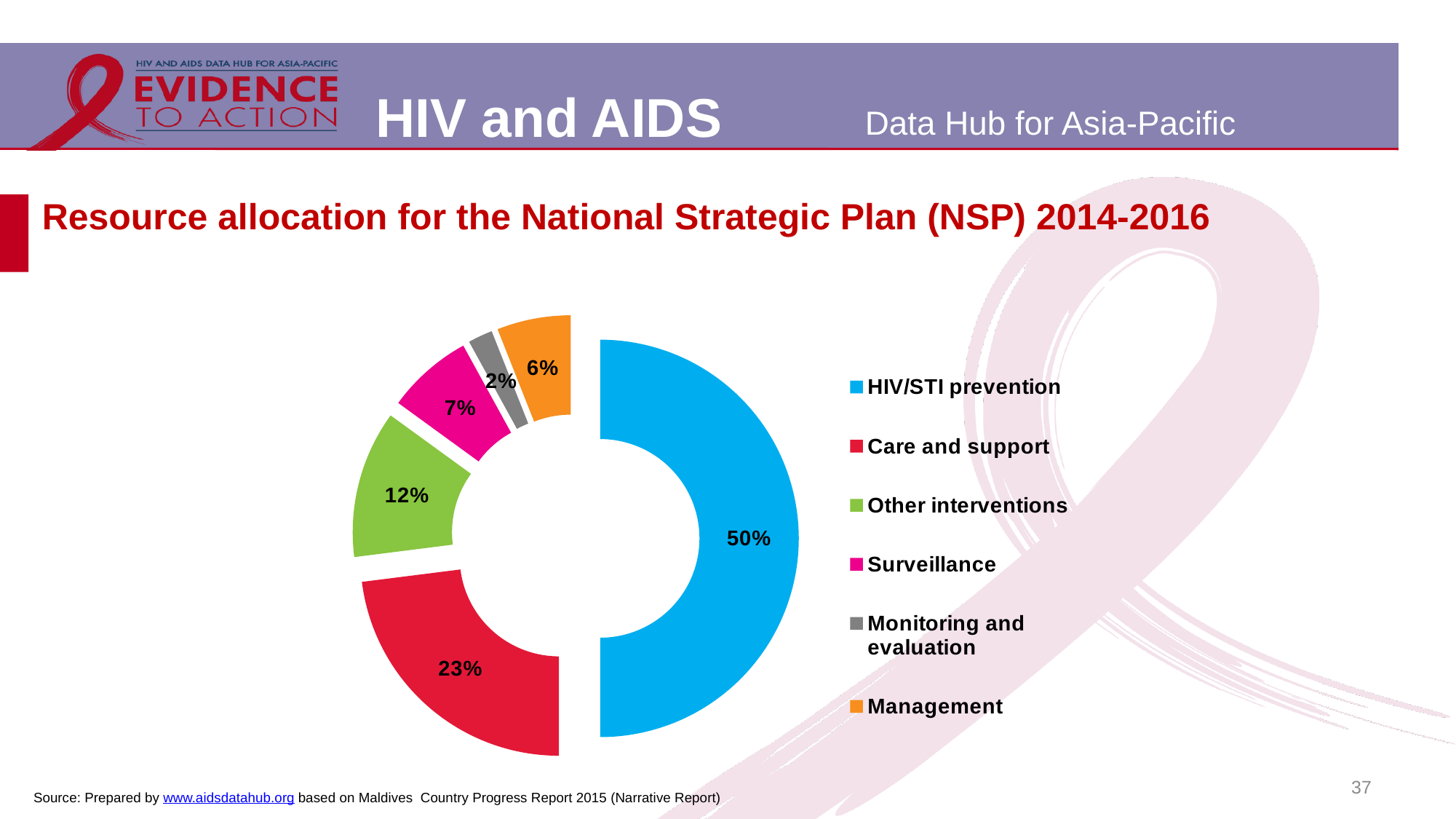
What percentage of resources is allocated to Care and support? 23% What type of chart is shown on the slide? Pie chart (doughnut) How many percentage points larger is the share for HIV/STI prevention than for Care and support? 27 What share of the NSP 2014-2016 resource allocation goes to HIV/STI prevention? 50% How many categories does the chart show? 6 Which category receives the smallest share of the resource allocation? Monitoring and evaluation What share is allocated to Other interventions? 12% Which receives a larger share: Surveillance or Management? Surveillance What percentage of the allocation goes to Surveillance? 7% Which category receives the largest share of the resource allocation? HIV/STI prevention What percentage of resources is allocated to Management? 6% What share is allocated to Monitoring and evaluation? 2%